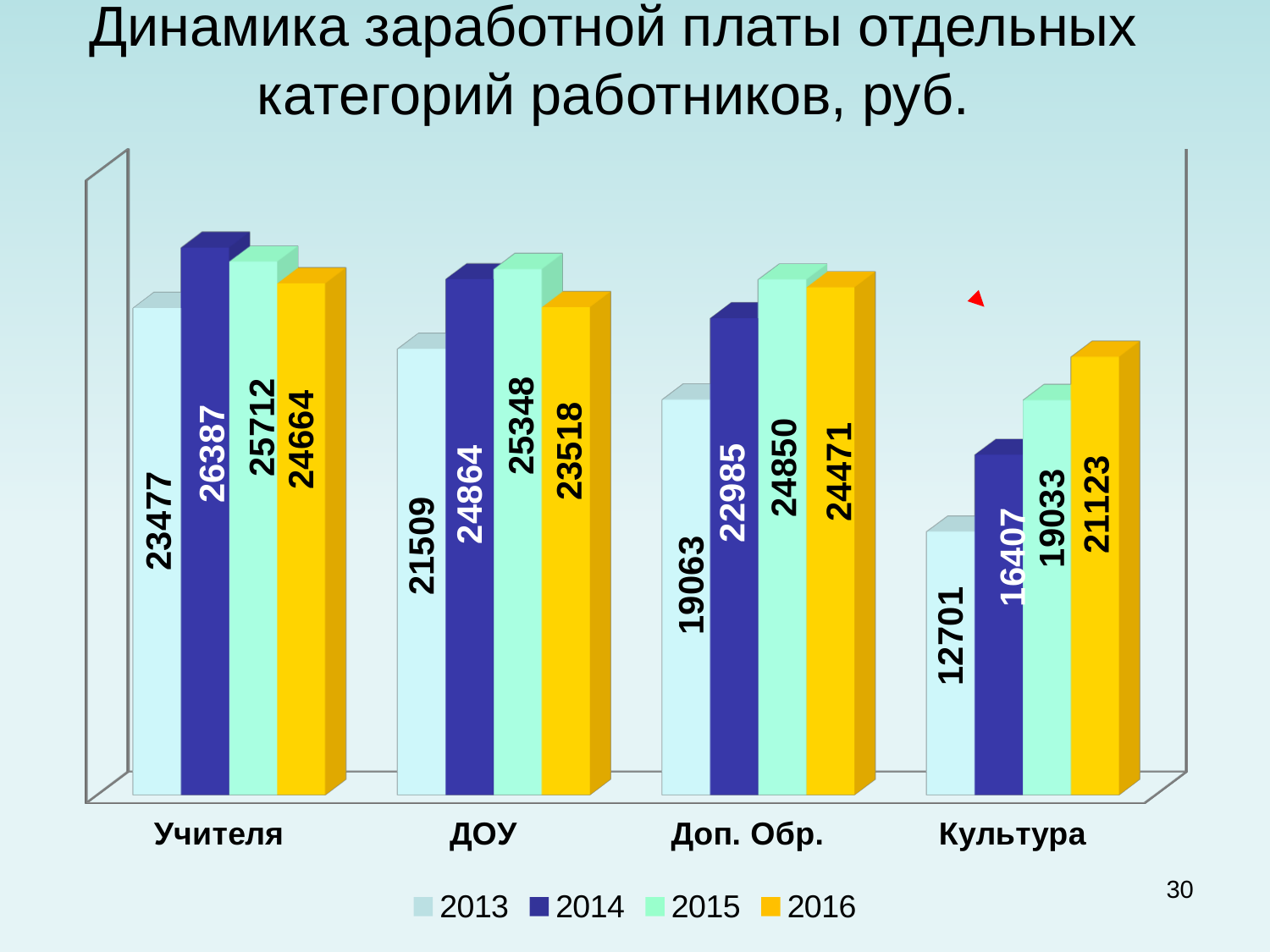
How many series does the legend list? 4 Which category has the highest value in 2014? Учителя What type of chart is shown on the slide? bar chart Which category has the lowest value in 2016? Культура What is the value for Учителя in 2014? 26387 Do the values for Культура rise or fall from 2013 to 2016? rise Which colour represents the 2016 series in the legend? yellow Which is larger for ДОУ: the 2015 value or the 2016 value? 2015 What is the difference between the 2016 and 2013 values for Культура? 8422 How many categories are shown on the x axis? 4 What is the value for Доп. Обр. in 2015? 24850 What is the value for Культура in 2013? 12701